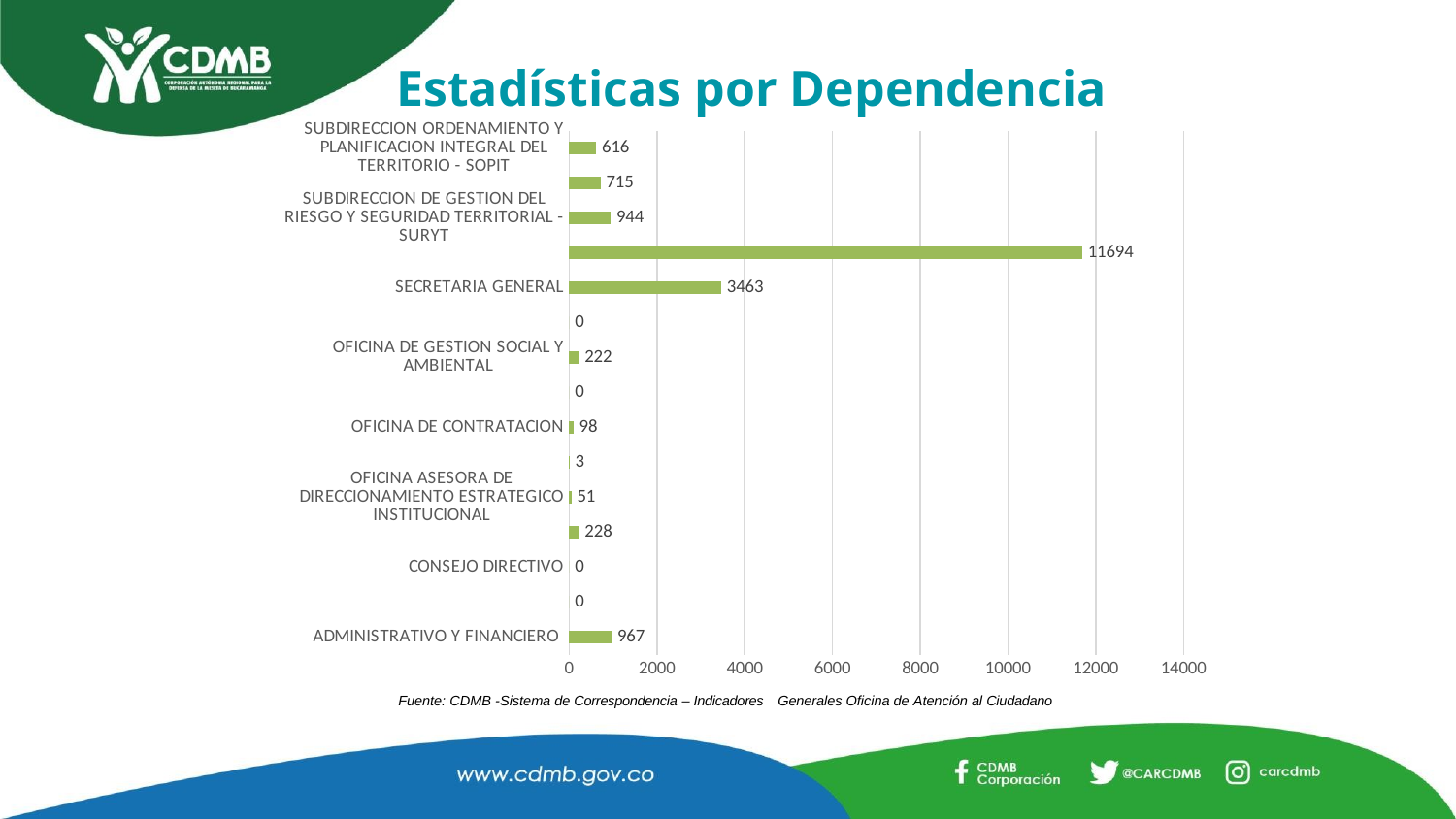
What is the difference between the value for SECRETARIA GENERAL and the value for ADMINISTRATIVO Y FINANCIERO? 2496 What is the maximum value shown on the horizontal axis? 14000 What is the value for SECRETARIA GENERAL? 3463 Is the value for SECRETARIA GENERAL greater or less than 2000? greater What is the title of the chart? Estadísticas por Dependencia What is the value for CONSEJO DIRECTIVO? 0 What is the value for OFICINA DE CONTRATACION? 98 What type of chart is shown on the slide? bar chart Which is larger, the value for ADMINISTRATIVO Y FINANCIERO or the value for SUBDIRECCION ORDENAMIENTO Y PLANIFICACION INTEGRAL DEL TERRITORIO - SOPIT? ADMINISTRATIVO Y FINANCIERO What is the largest value labelled on the chart? 11694 What is the value for OFICINA DE GESTION SOCIAL Y AMBIENTAL? 222 What is the value for ADMINISTRATIVO Y FINANCIERO? 967